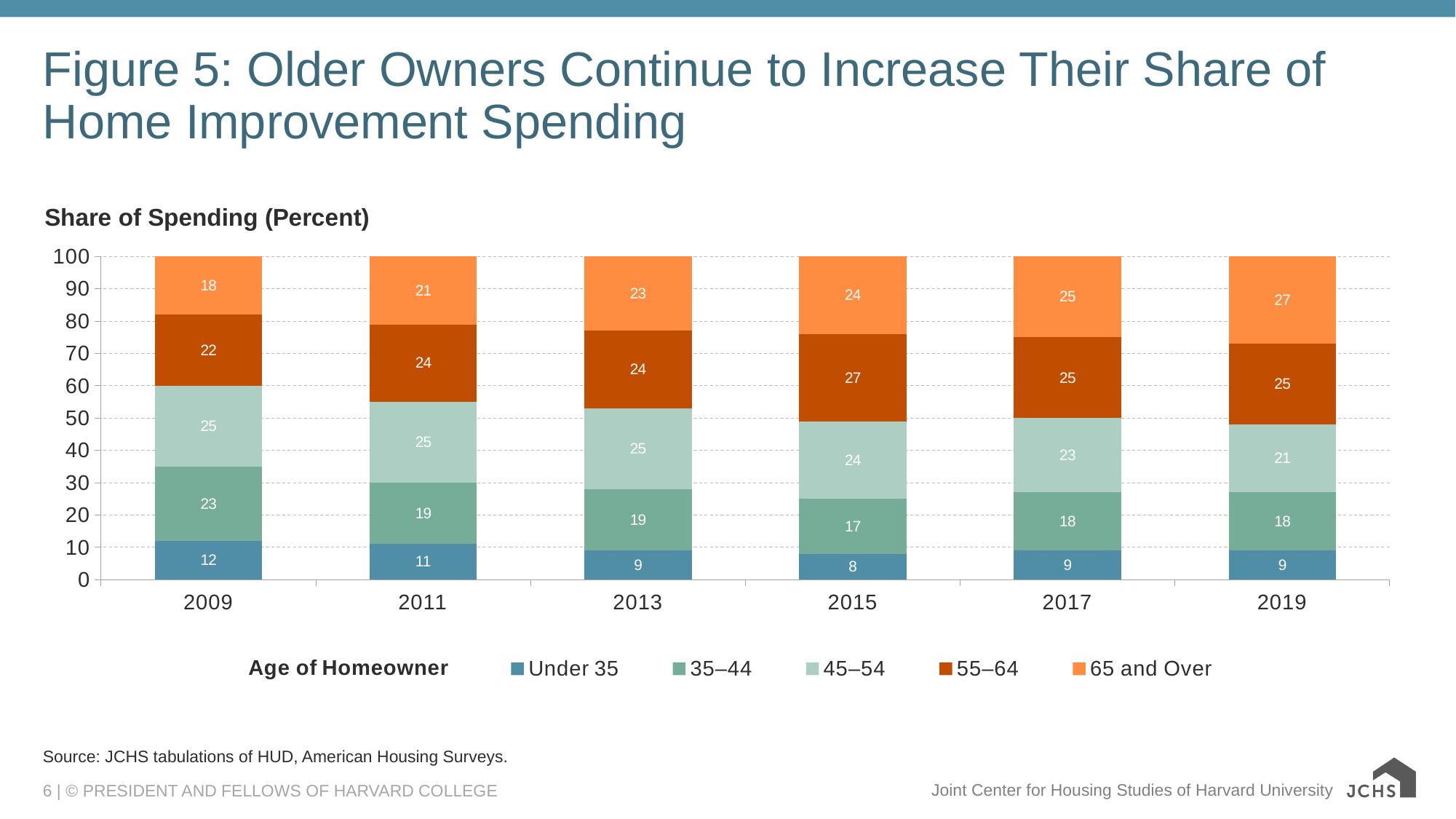
In which year is the share of spending for homeowners Under 35 the lowest? 2015 How many age groups does the legend list? 5 In which year is the share of spending for homeowners aged 65 and Over the highest? 2019 Does the share of spending for homeowners aged 65 and Over rise or fall from 2009 to 2019? Rise What is the share of spending for homeowners Under 35 in 2009? 12 How many years are shown on the x axis? 6 What is the share of spending for homeowners aged 55–64 in 2015? 27 What kind of chart is shown on the slide? Stacked bar chart What is the share of spending for homeowners aged 65 and Over in 2019? 27 Which is larger in 2013: the share for 45–54 or the share for 35–44? 45–54 What is the combined share of spending for the 55–64 and 65 and Over groups in 2017? 50 What is the difference between the 65 and Over share in 2019 and in 2009? 9